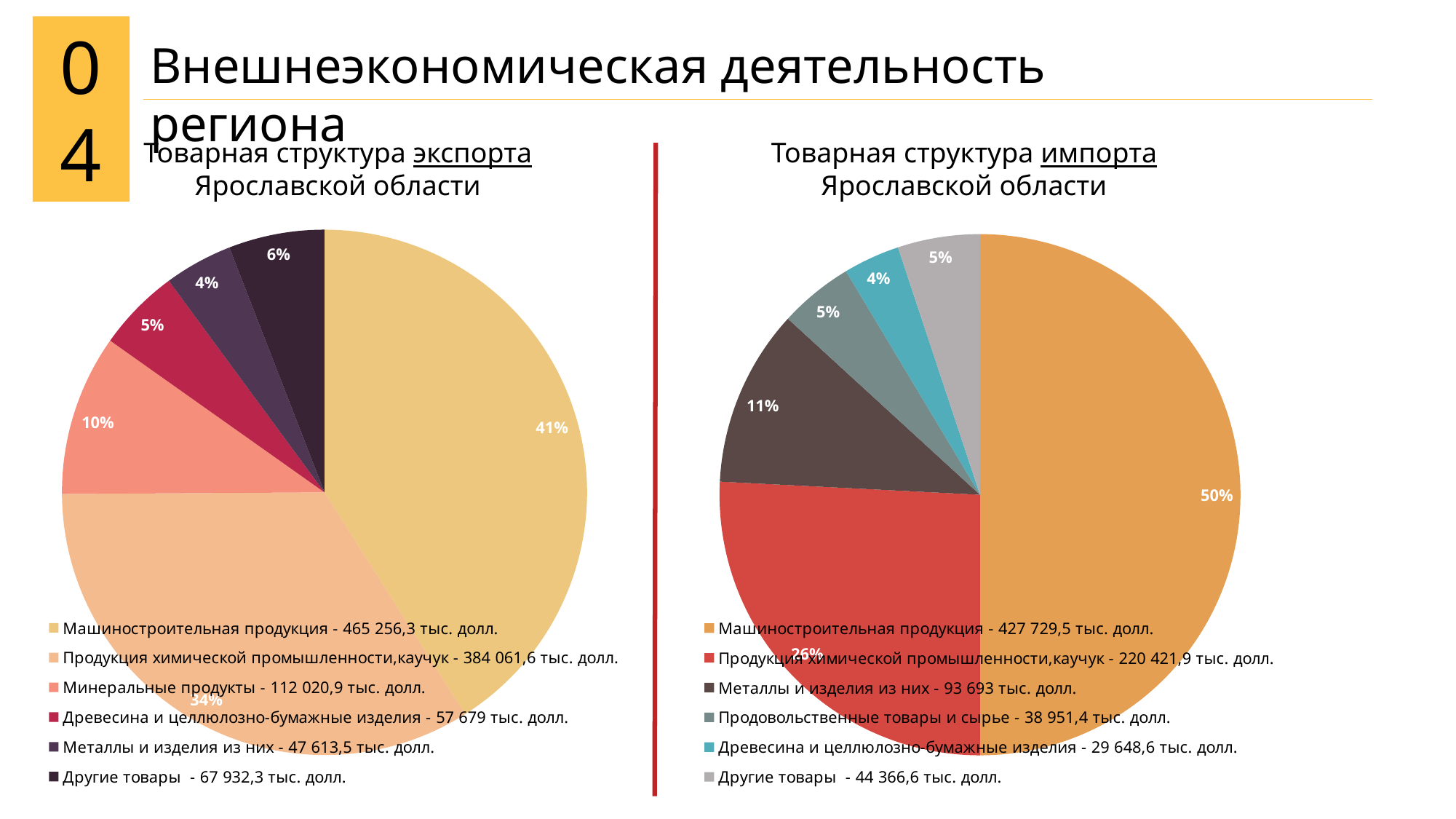
In the 'Товарная структура импорта Ярославской области' chart, which category has the smallest share? Древесина и целлюлозно-бумажные изделия In the 'Товарная структура импорта Ярославской области' chart, what share does 'Металлы и изделия из них' have? 11% In the 'Товарная структура экспорта Ярославской области' chart, what share does 'Минеральные продукты' have? 10% In the 'Товарная структура экспорта Ярославской области' chart, how many categories does the legend list? 6 In the 'Товарная структура экспорта Ярославской области' legend, what value is given for 'Древесина и целлюлозно-бумажные изделия'? 57 679 тыс. долл. In the 'Товарная структура экспорта Ярославской области' chart, which category has the largest share? Машиностроительная продукция What type of chart is used for the 'Товарная структура экспорта Ярославской области'? Pie chart In the 'Товарная структура импорта Ярославской области' chart, what share does 'Машиностроительная продукция' have? 50% In the 'Товарная структура импорта Ярославской области' legend, what value is given for 'Продукция химической промышленности,каучук'? 220 421,9 тыс. долл. In the 'Товарная структура импорта Ярославской области' chart, what is the difference in percentage points between the shares of 'Машиностроительная продукция' and 'Продукция химической промышленности,каучук'? 24 percentage points In the 'Товарная структура экспорта Ярославской области' chart, which category has the smallest share? Металлы и изделия из них